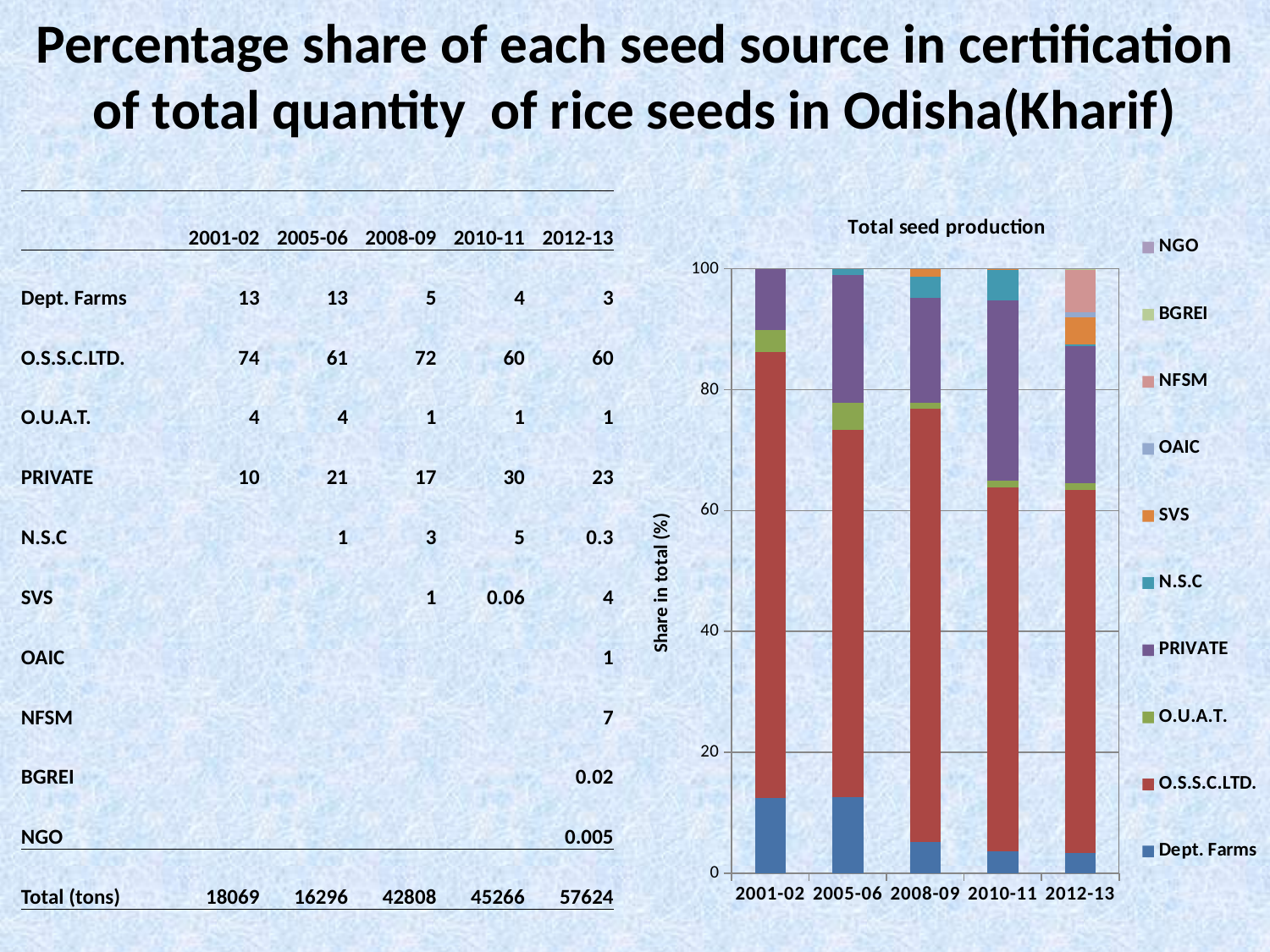
What is the label of the chart's y axis? Share in total (%) What kind of chart is shown on the slide? Stacked bar chart What is the title of the chart on the slide? Total seed production Is the Dept. Farms segment for 2001-02 greater or less than 20? less How many series does the chart's legend list? 10 What is the total height of each stacked bar in the chart? 100 Which is larger, the Dept. Farms segment in 2001-02 or in 2012-13? 2001-02 Is the top of the O.S.S.C.LTD. segment in the 2001-02 bar greater or less than 80? greater How many years (bars) are shown on the x axis of the chart? 5 Is the top of the O.S.S.C.LTD. segment in the 2005-06 bar greater or less than 80? less In which year is the PRIVATE segment the largest? 2010-11 Does the Dept. Farms share rise or fall from 2001-02 to 2012-13? fall